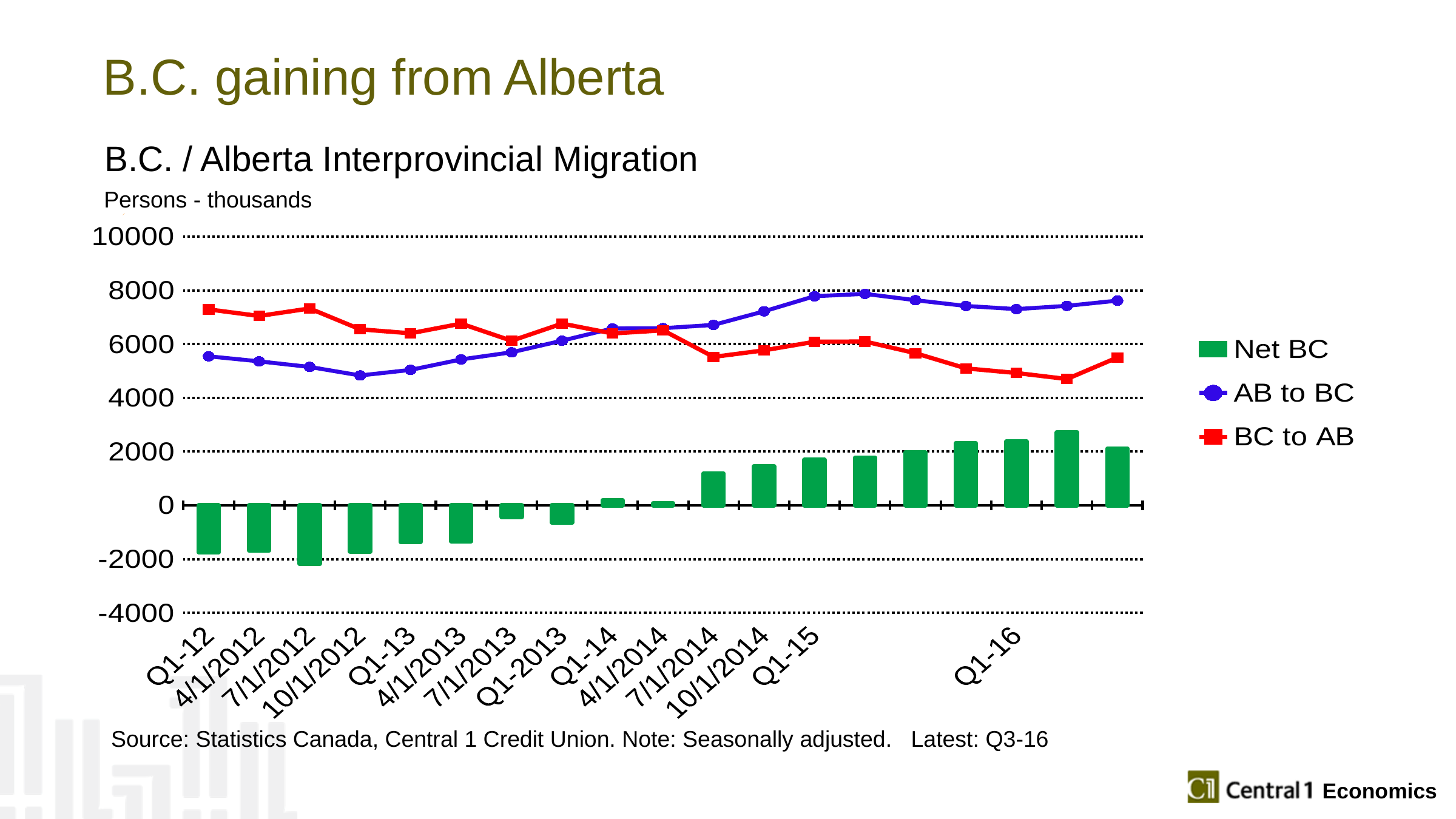
Does the Net BC series generally rise or fall from Q1-12 to Q1-16? rise At Q1-12, which is larger: AB to BC or BC to AB? BC to AB What kind of chart is this? Combined bar and line chart Is the BC to AB value for Q1-12 greater or less than 6000? greater Is the Net BC value for Q1-15 greater or less than 0? greater Is the BC to AB value for Q1-16 greater or less than 6000? less Which series is shown as green bars? Net BC How many series does the chart legend list? 3 At Q1-16, which is larger: AB to BC or BC to AB? AB to BC What is the title of the chart? B.C. / Alberta Interprovincial Migration